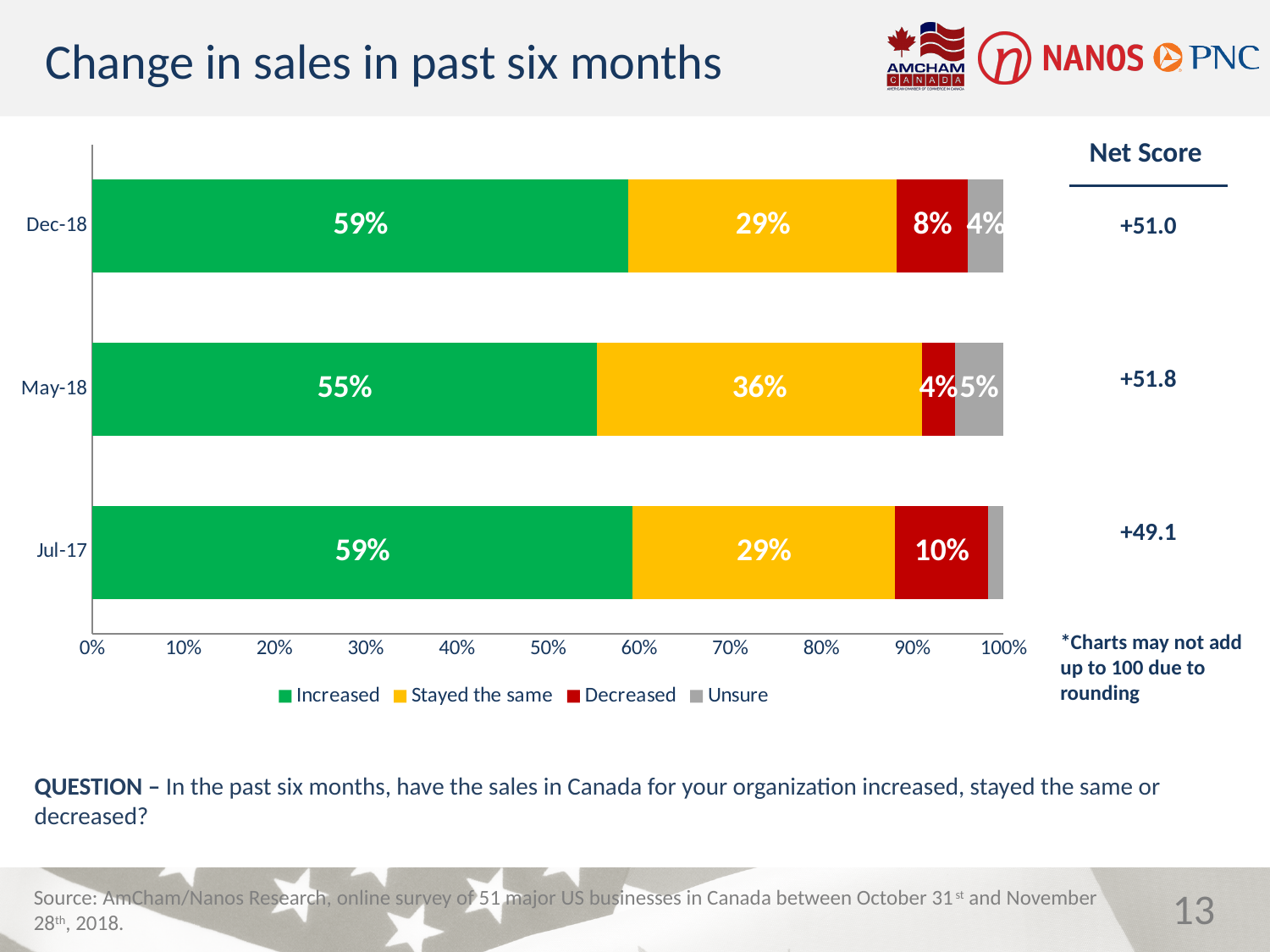
Is the 'Increased' value for May-18 greater or less than 50%? greater Which period has the highest share of respondents saying sales decreased? Jul-17 Is the 'Decreased' share larger in Dec-18 or in May-18? Dec-18 What percentage of respondents were unsure in May-18? 5% How many series does the legend list? 4 What percentage of respondents said sales stayed the same in May-18? 36% What is the difference between the 'Stayed the same' share in May-18 and in Dec-18? 7% Which period has the lowest share of respondents saying sales increased? May-18 What percentage of respondents said sales decreased in Jul-17? 10% What percentage of respondents said sales increased in Dec-18? 59% What type of chart is shown on the slide? Stacked bar chart How many time periods are shown on the chart? 3